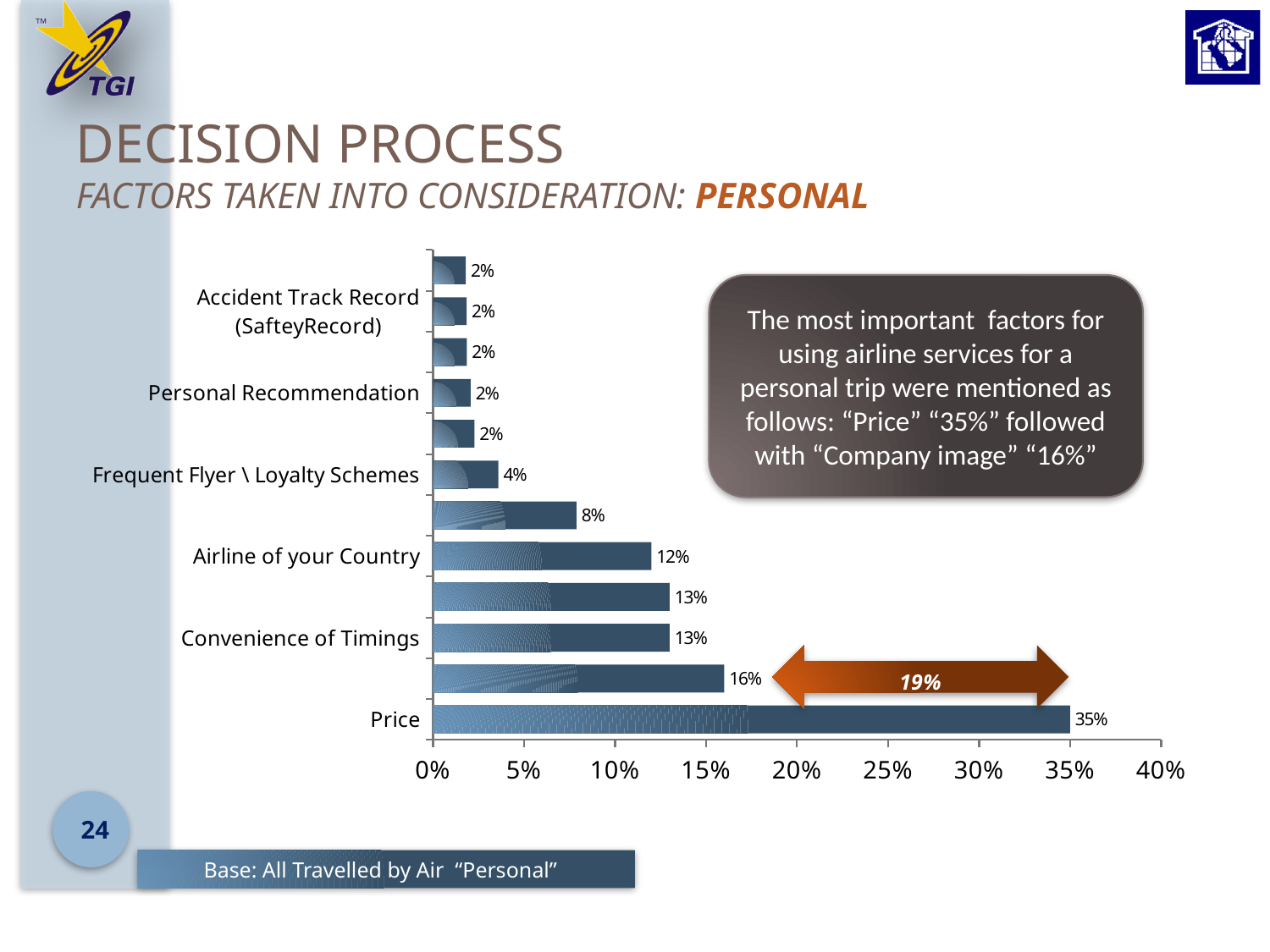
What is the value for Personal Recommendation? 2% How many bars are plotted in the chart? 12 What is the value for Airline of your Country? 12% What is the value for Convenience of Timings? 13% What kind of chart is shown on the slide? Bar chart What is the difference between the values for Price and Convenience of Timings? 22 percentage points What is the value for Frequent Flyer \ Loyalty Schemes? 4% What is the value for Price? 35% Which factor has the highest value? Price What is the difference between the values for Price and Airline of your Country? 23 percentage points What is the maximum value shown on the horizontal axis? 40% Which is larger, the value for Airline of your Country or the value for Frequent Flyer \ Loyalty Schemes? Airline of your Country